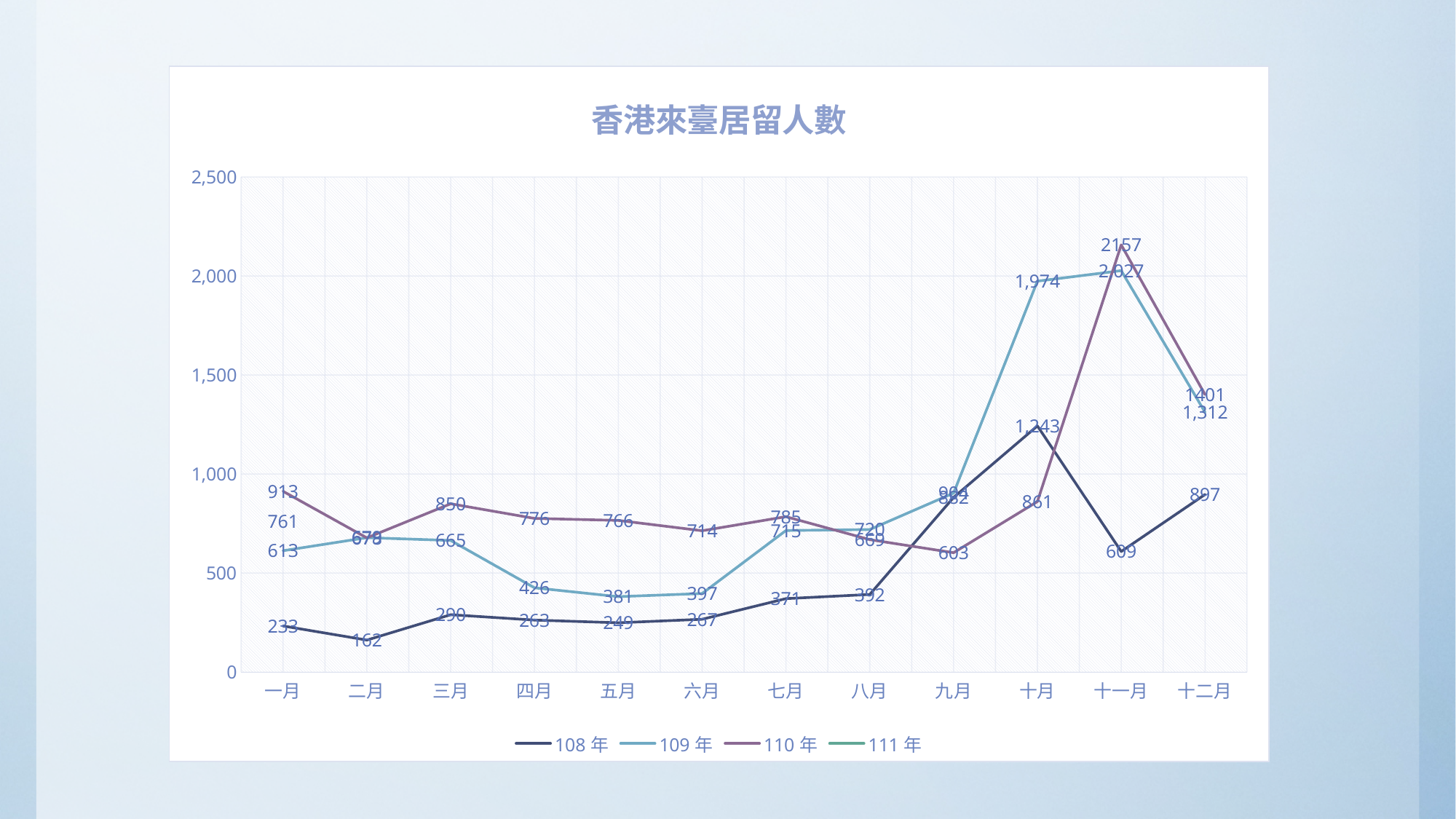
What is the value for 110 年 in 十一月? 2157 What is the title of the chart? 香港來臺居留人數 What is the difference between the 109 年 and 108 年 values in 十一月? 1,418 What kind of chart is shown on the slide? line chart What is the value for 109 年 in 十月? 1,974 In which month is the 108 年 series highest? 十月 How many series does the legend list? 4 In which month is the 108 年 series lowest? 二月 What is the value for 108 年 in 二月? 162 How many months are shown along the x axis? 12 In 十二月, which series has the larger value, 109 年 or 110 年? 110 年 Is the value for 108 年 in 十月 greater or less than 1,000? greater